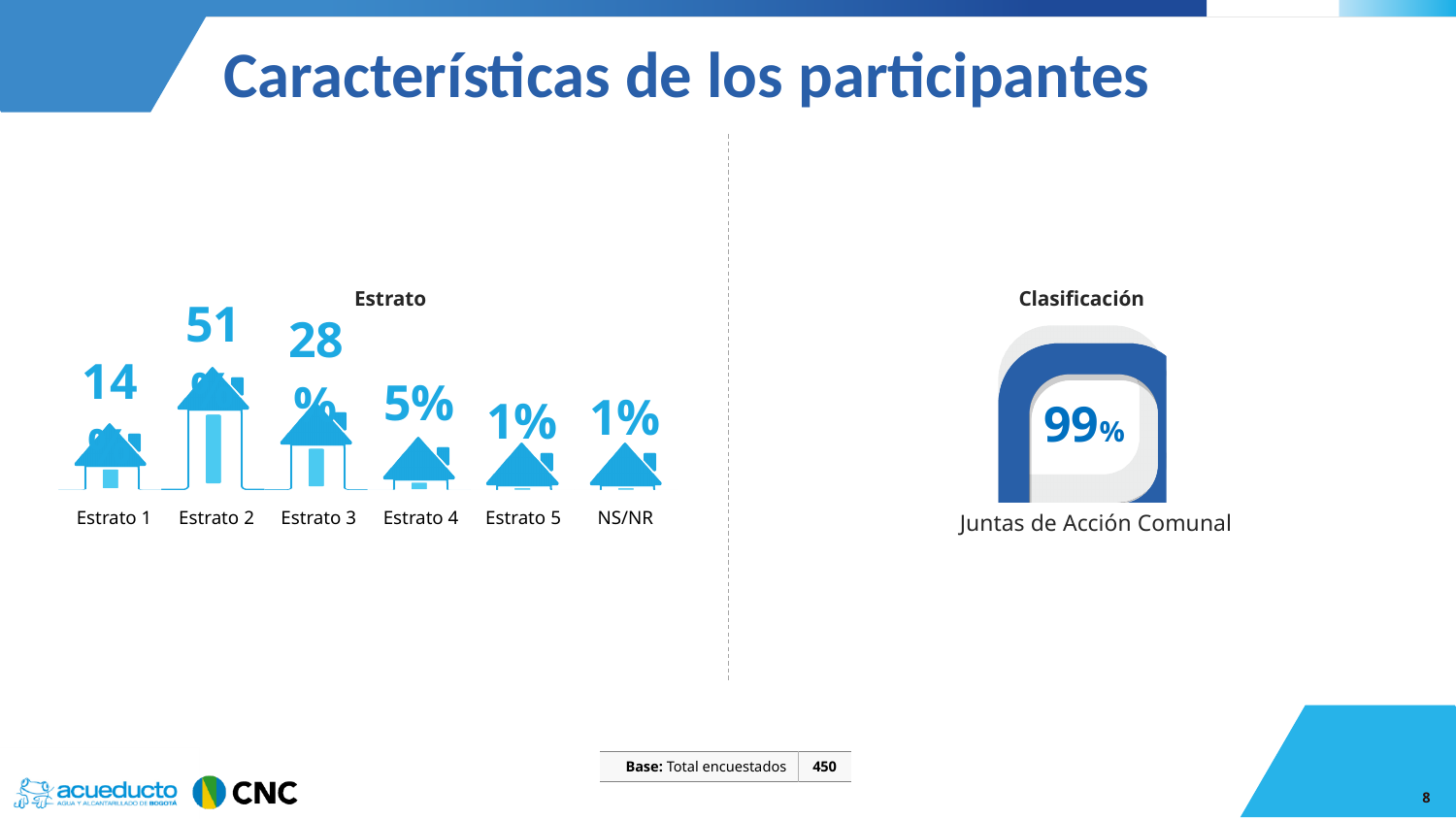
What kind of chart is the Estrato chart? Bar chart How many categories are shown in the Estrato chart? 6 In the Estrato chart, which category has the larger value, Estrato 3 or Estrato 4? Estrato 3 In the Estrato chart, what is the difference between the values for Estrato 4 and Estrato 5? 4% In the Estrato chart, which category has the highest value? Estrato 2 In the Estrato chart, what is the value for NS/NR? 1% In the Estrato chart, what is the value for Estrato 5? 1% In the Estrato chart, what is the difference between the values for Estrato 3 and Estrato 4? 23% In the Estrato chart, what is the value for Estrato 4? 5% In the Estrato chart, which category has the larger value, Estrato 1 or Estrato 2? Estrato 2 In the Estrato chart, what is the value for Estrato 3? 28% What is the base (total encuestados) shown on the slide? 450